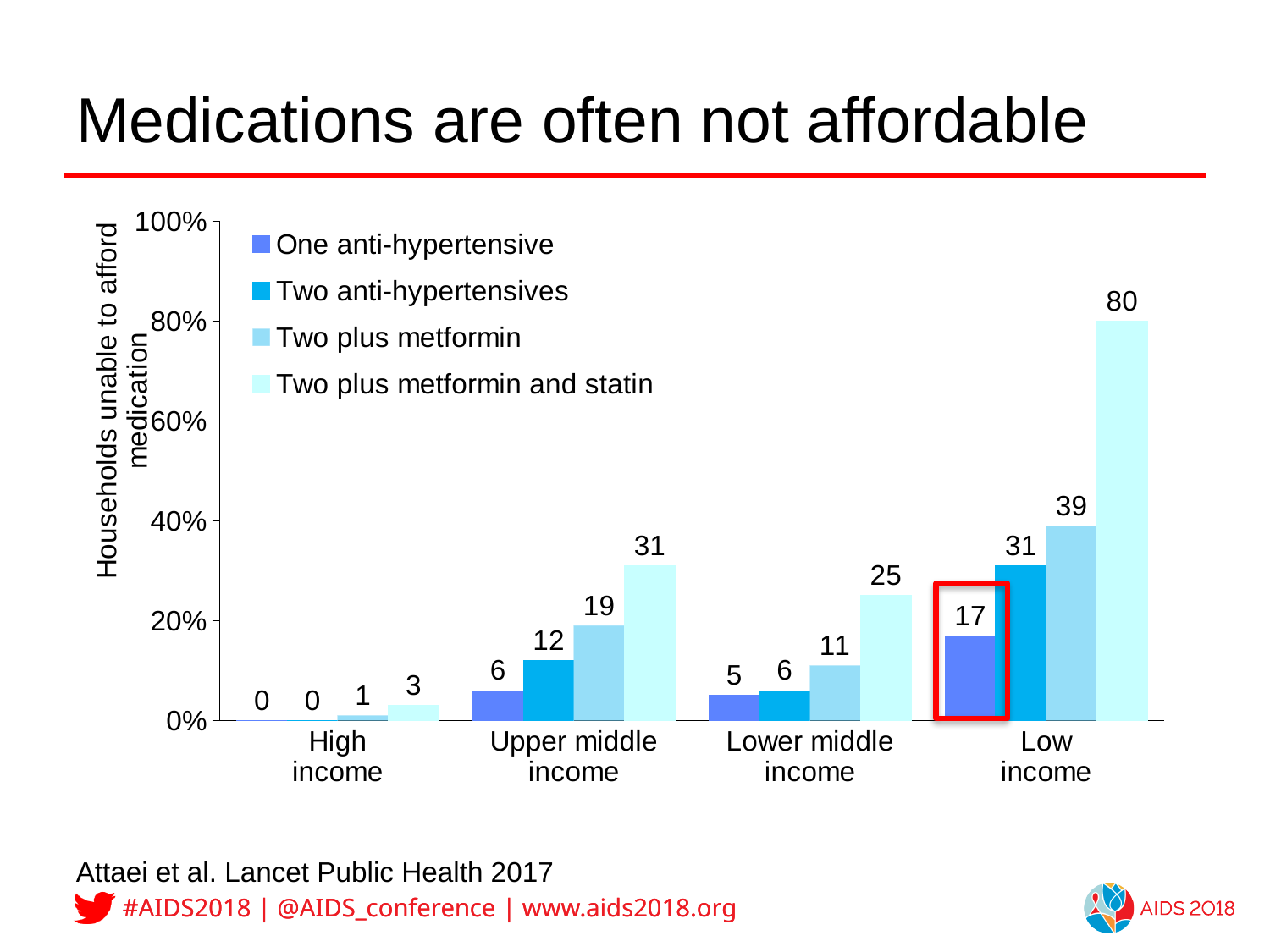
What is the value for Two plus metformin in the Upper middle income category? 19 Which is larger: the Two plus metformin value for Low income or the Two plus metformin and statin value for Lower middle income? Two plus metformin for Low income What is the difference between the Two plus metformin and statin values for Low income and Upper middle income? 49 Which income category has the lowest value for Two plus metformin? High income What is the value for Two anti-hypertensives in the Lower middle income category? 6 How many series does the legend list? 4 How many income categories are shown on the x axis? 4 What is the value for One anti-hypertensive in the Low income category? 17 Which income category has the highest value for Two plus metformin and statin? Low income What kind of chart is shown on the slide? Bar chart What is the value for Two plus metformin and statin in the Low income category? 80 Do the Two plus metformin and statin values rise or fall moving from High income to Low income along the x axis? Rise